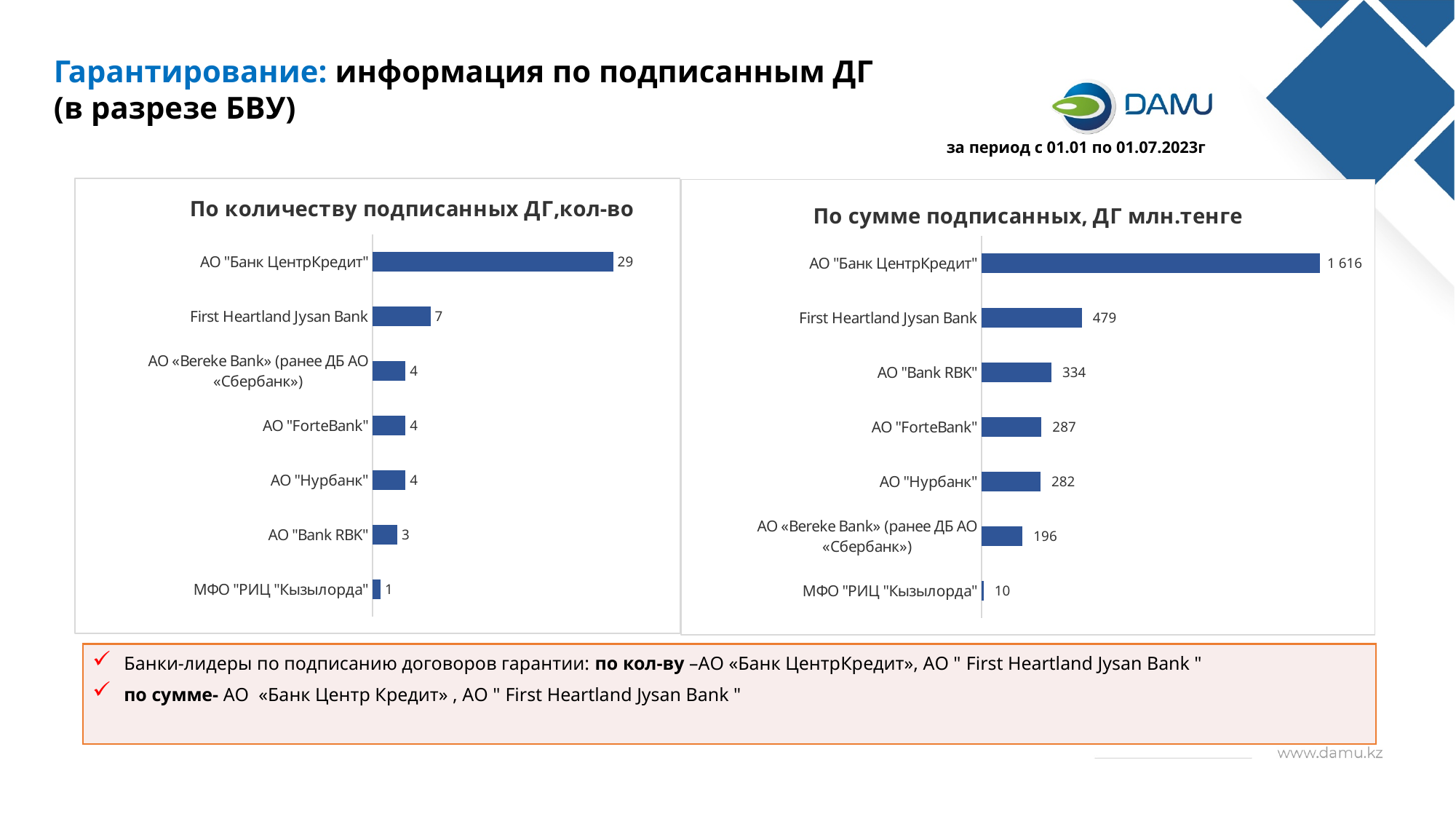
In the chart "По сумме подписанных, ДГ млн.тенге", which is larger: АО "ForteBank" or АО "Нурбанк"? АО "ForteBank" In the chart "По количеству подписанных ДГ,кол-во", what is the difference between АО "Банк ЦентрКредит" and First Heartland Jysan Bank? 22 What type of chart is "По сумме подписанных, ДГ млн.тенге"? Bar chart In the chart "По сумме подписанных, ДГ млн.тенге", which category has the highest value? АО "Банк ЦентрКредит" In the chart "По сумме подписанных, ДГ млн.тенге", what is the difference between First Heartland Jysan Bank and АО "Bank RBK"? 145 In the chart "По сумме подписанных, ДГ млн.тенге", what is the value for АО "Банк ЦентрКредит"? 1 616 In the chart "По количеству подписанных ДГ,кол-во", how many categories are shown? 7 In the chart "По количеству подписанных ДГ,кол-во", what is the value for First Heartland Jysan Bank? 7 In the chart "По сумме подписанных, ДГ млн.тенге", what is the value for АО «Bereke Bank» (ранее ДБ АО «Сбербанк»)? 196 In the chart "По количеству подписанных ДГ,кол-во", which category has the lowest value? МФО "РИЦ "Кызылорда" In the chart "По количеству подписанных ДГ,кол-во", what is the value for АО "Банк ЦентрКредит"? 29 In the chart "По сумме подписанных, ДГ млн.тенге", what is the value for АО "Bank RBK"? 334